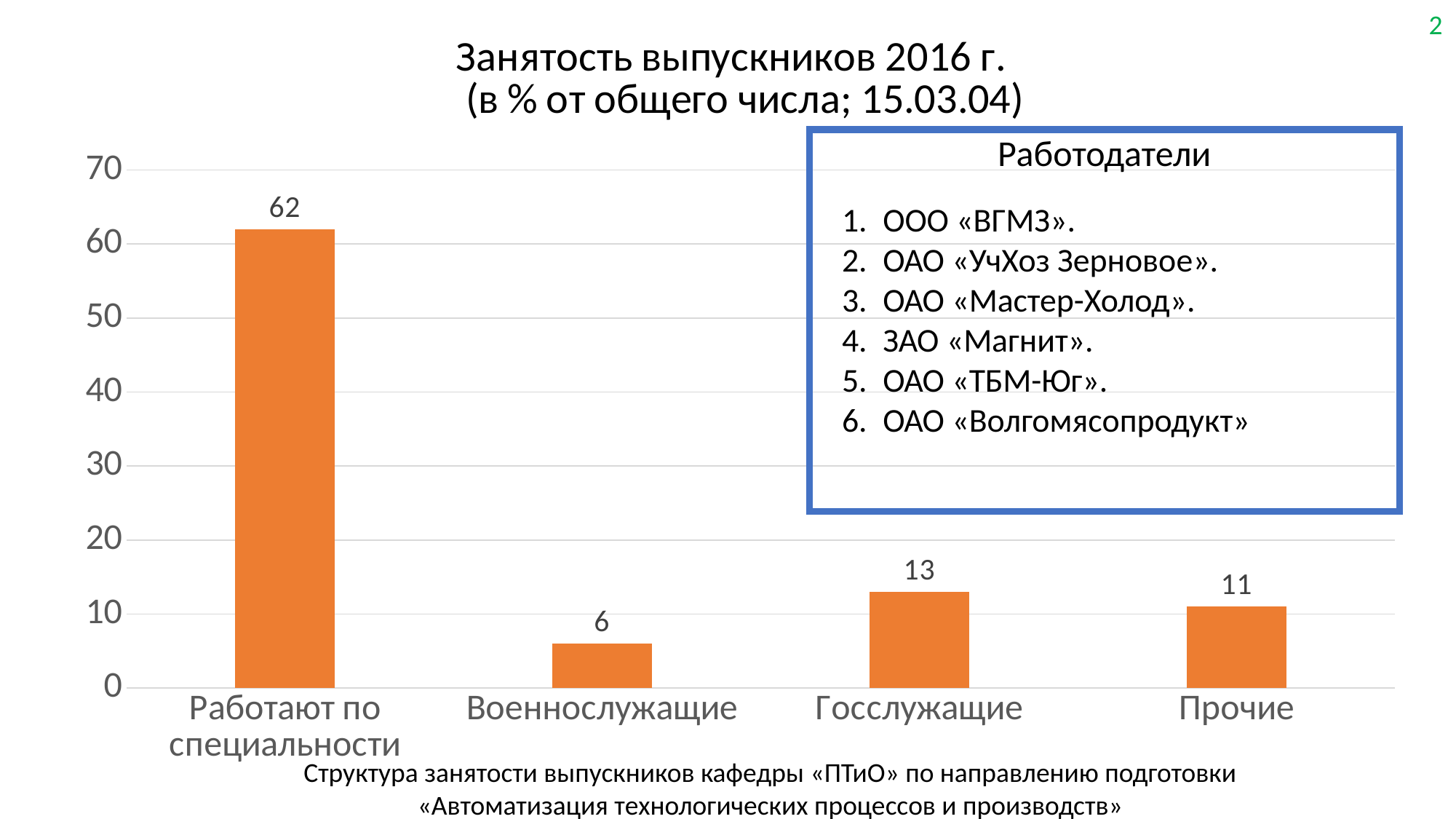
What kind of chart is shown on the slide? Bar chart What is the value for «Госслужащие»? 13 What is the value for «Военнослужащие»? 6 Which category has the highest value? Работают по специальности Which category has the lowest value? Военнослужащие What is the title of the chart? Занятость выпускников 2016 г. (в % от общего числа; 15.03.04) What is the value for «Работают по специальности»? 62 What is the difference between the values for «Госслужащие» and «Прочие»? 2 Which is larger, the value for «Госслужащие» or the value for «Военнослужащие»? Госслужащие How many categories are shown on the chart? 4 What is the value for «Прочие»? 11 What is the difference between the values for «Работают по специальности» and «Госслужащие»? 49